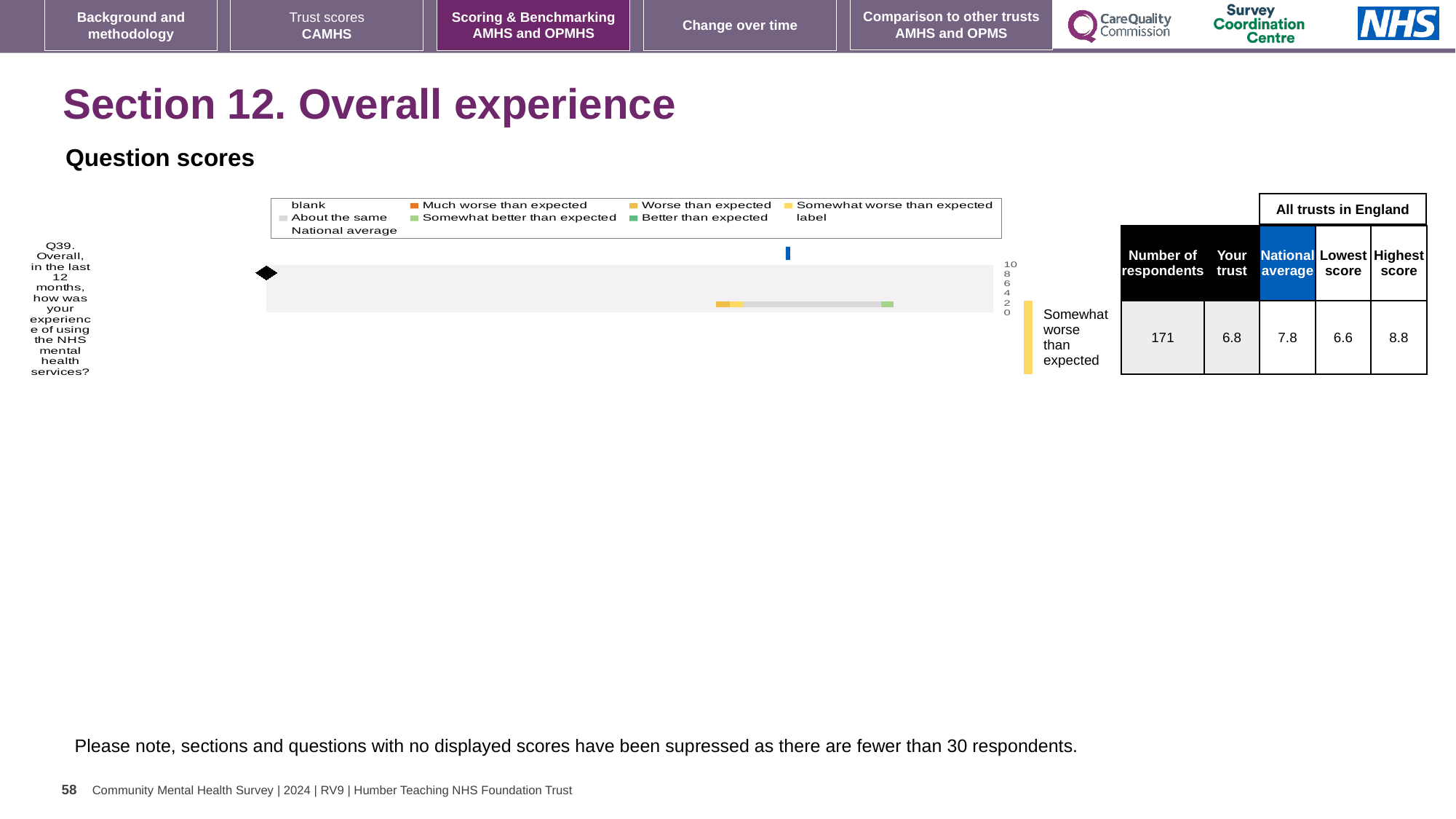
Which is larger for Q39: the 'Your trust' score or the national average? National average What kind of chart is used to show the Q39 question score? Bar chart How many respondents answered Q39? 171 What is the highest score among all trusts in England for Q39? 8.8 What is the lowest score among all trusts in England for Q39? 6.6 What is the 'Your trust' score for Q39 (Overall, in the last 12 months, how was your experience of using the NHS mental health services?)? 6.8 Is the 'Your trust' score for Q39 greater or less than 8? less What is the difference between the highest and lowest scores for Q39 across all trusts in England? 2.2 Which benchmark category is shown next to the Q39 chart? Somewhat worse than expected How many questions are plotted in the Question scores chart? 1 What is the national average score for Q39? 7.8 By how much does the national average exceed the 'Your trust' score for Q39? 1.0